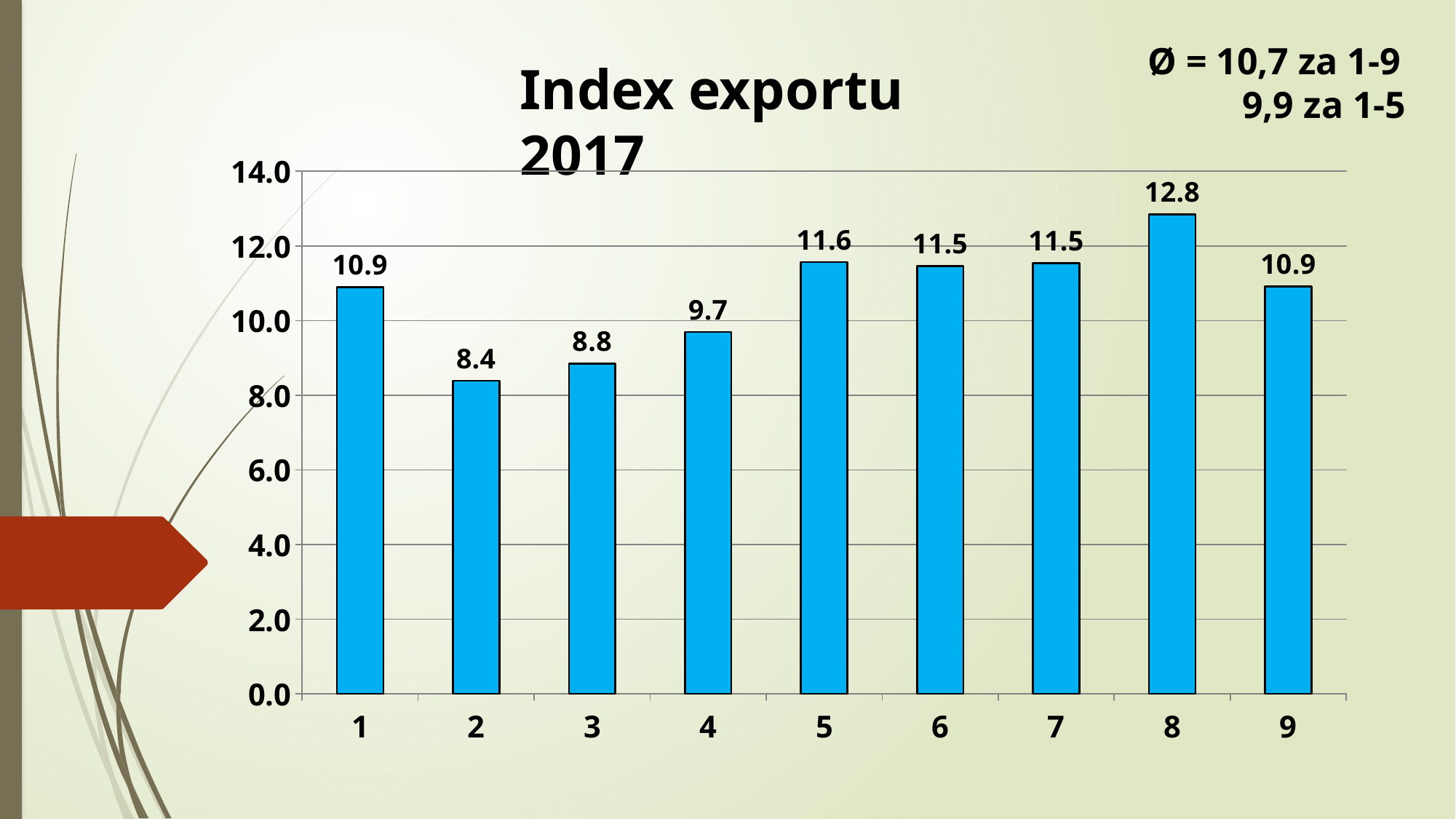
What is the difference between the values for category 8 and category 2? 4.4 What is the value for category 8? 12.8 Which category has the highest value? 8 What is the value for category 5? 11.6 Which category has the lowest value? 2 How many categories are shown on the x axis? 9 Is the value for category 3 greater or less than 10.0? less What is the title of the chart? Index exportu 2017 Which is larger, the value for category 1 or the value for category 4? category 1 What is the difference between the values for category 4 and category 3? 0.9 What kind of chart is shown on the slide? bar chart What is the value for category 2? 8.4